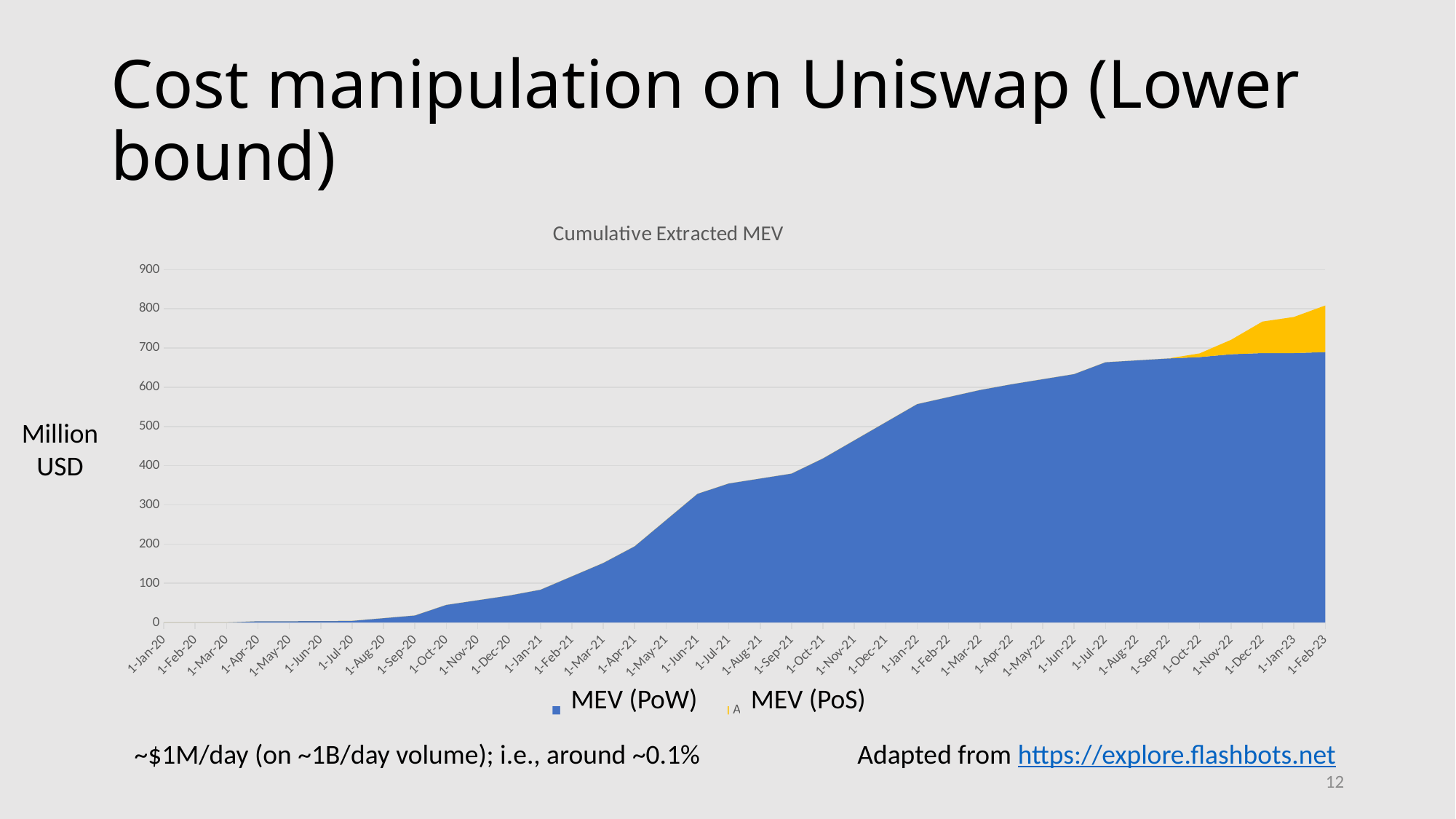
How many monthly dates are shown on the x axis? 38 Is the value for MEV (PoW) at 1-Jan-21 greater or less than 100? less How many series does the chart's legend list? 2 Is the value for MEV (PoW) at 1-Oct-20 greater or less than 100? less What kind of chart is shown on the slide? Area chart What is the title of the chart? Cumulative Extracted MEV Is the value for MEV (PoW) at 1-Jan-22 greater or less than 500? greater Do the cumulative MEV values rise or fall along the x axis from 1-Jan-20 to 1-Feb-23? Rise Which colour represents the MEV (PoS) series? Yellow